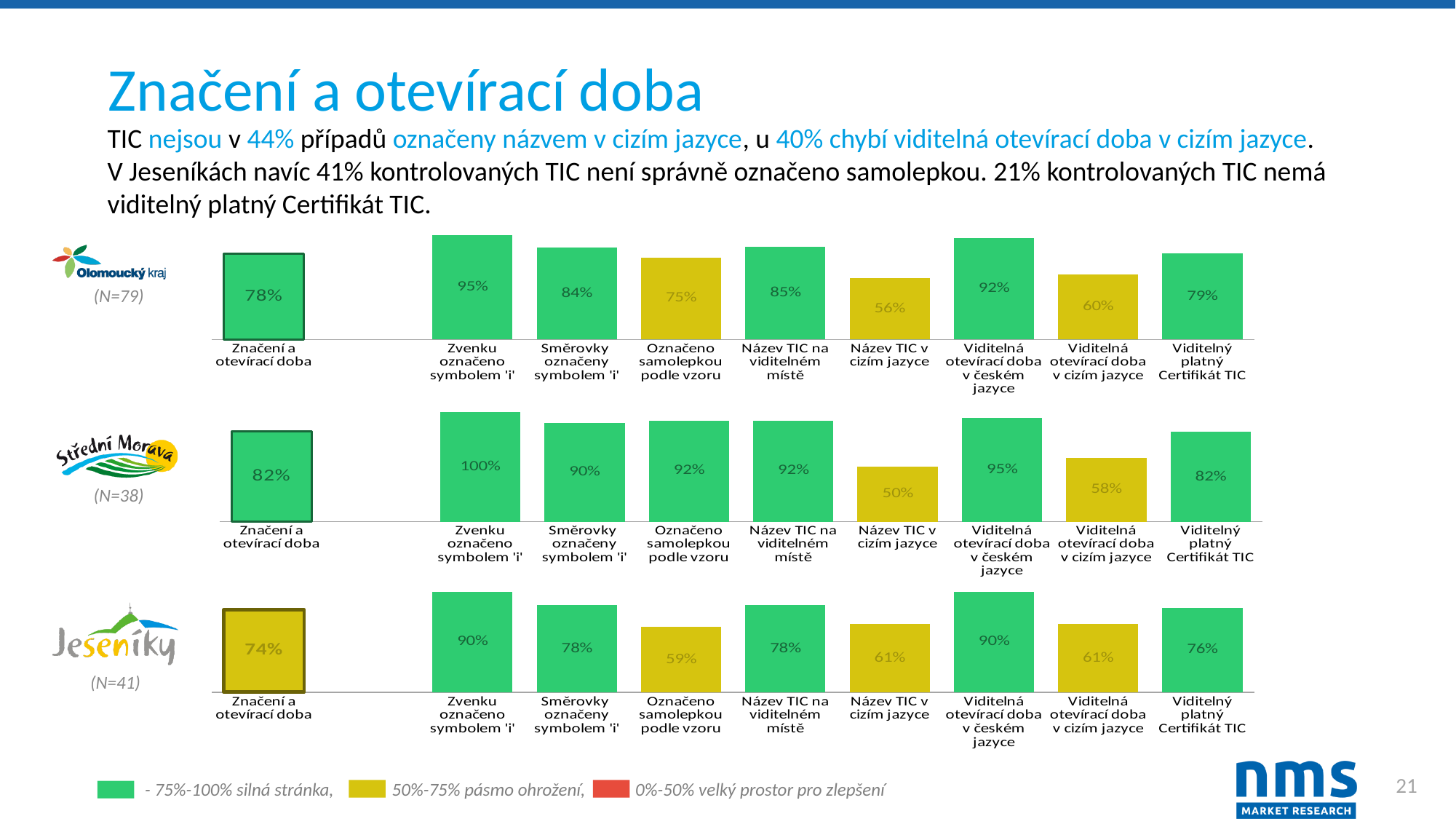
In the Jeseníky chart (bottom), what is the value for 'Označeno samolepkou podle vzoru'? 59% In the Olomoucký kraj chart (top), what is the value for 'Název TIC v cizím jazyce'? 56% According to the legend at the bottom of the slide, what range of values does the yellow colour represent? 50%-75% pásmo ohrožení In the Střední Morava chart (middle), which category has the lowest value? Název TIC v cizím jazyce In the Střední Morava chart (middle), what is the difference between 'Viditelná otevírací doba v českém jazyce' and 'Viditelná otevírací doba v cizím jazyce'? 37% In the Střední Morava chart (middle), what is the value for 'Zvenku označeno symbolem 'i''? 100% In the Jeseníky chart (bottom), what is the value for 'Značení a otevírací doba'? 74% How many categories are plotted in the Střední Morava chart (middle)? 9 In the Olomoucký kraj chart (top), which is larger: 'Viditelná otevírací doba v českém jazyce' or 'Viditelná otevírací doba v cizím jazyce'? Viditelná otevírací doba v českém jazyce What kind of chart is used for the Jeseníky data (bottom)? Bar chart In the Jeseníky chart (bottom), what is the difference between 'Zvenku označeno symbolem 'i'' and 'Směrovky označeny symbolem 'i''? 12% In the Olomoucký kraj chart (top), which category has the highest value? Zvenku označeno symbolem 'i'